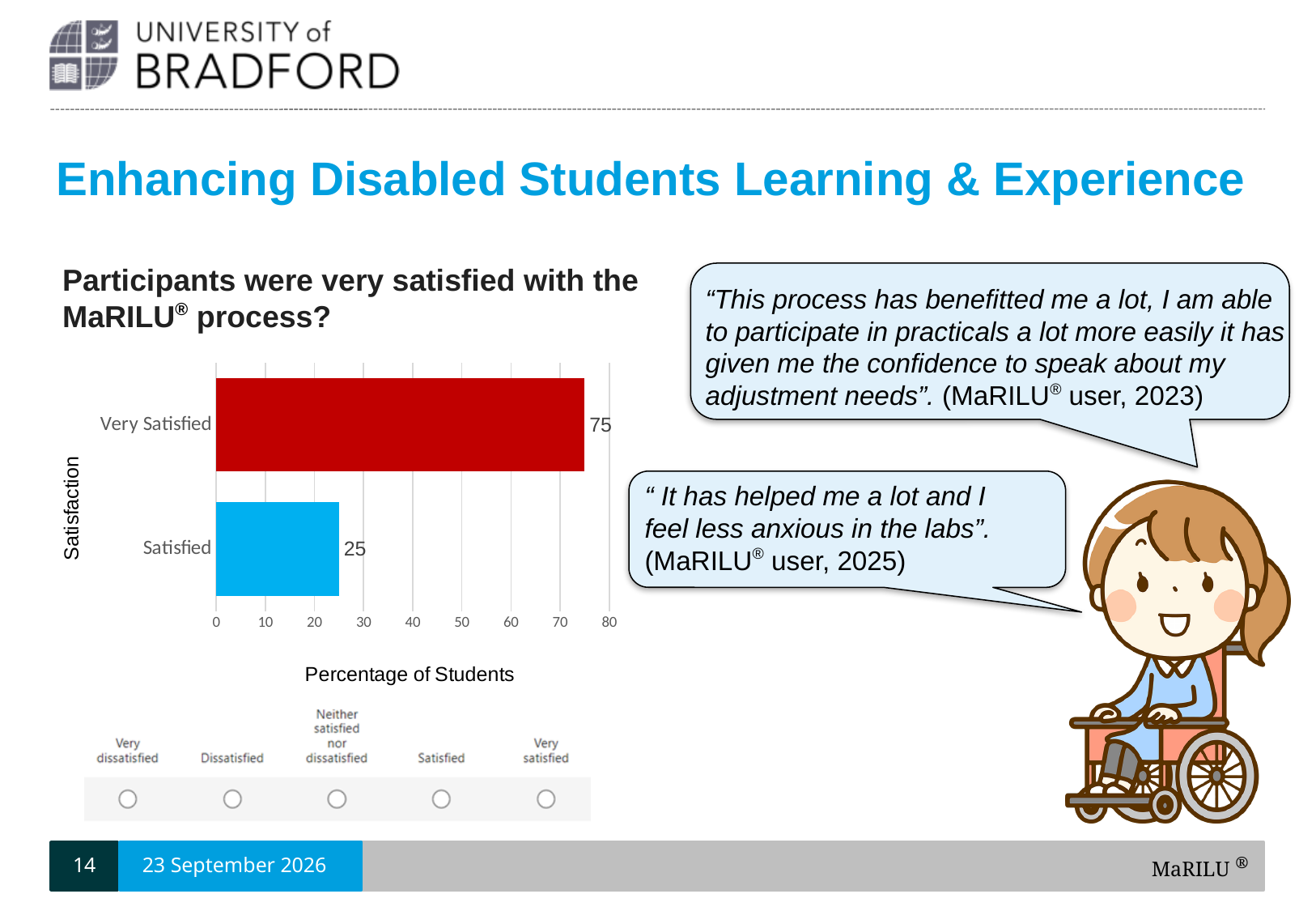
What is the difference between the values for Very Satisfied and Satisfied? 50 What is the value for Satisfied? 25 Which category has the lowest value? Satisfied What is the label of the vertical axis of the chart? Satisfaction What is the label of the horizontal axis of the chart? Percentage of Students Is the value for Satisfied greater or less than 30? less What kind of chart is shown on the slide? bar chart Which is larger, the value for Very Satisfied or the value for Satisfied? Very Satisfied Is the value for Very Satisfied greater or less than 70? greater Which category has the highest value? Very Satisfied How many categories are shown in the bar chart? 2 What is the value for Very Satisfied? 75